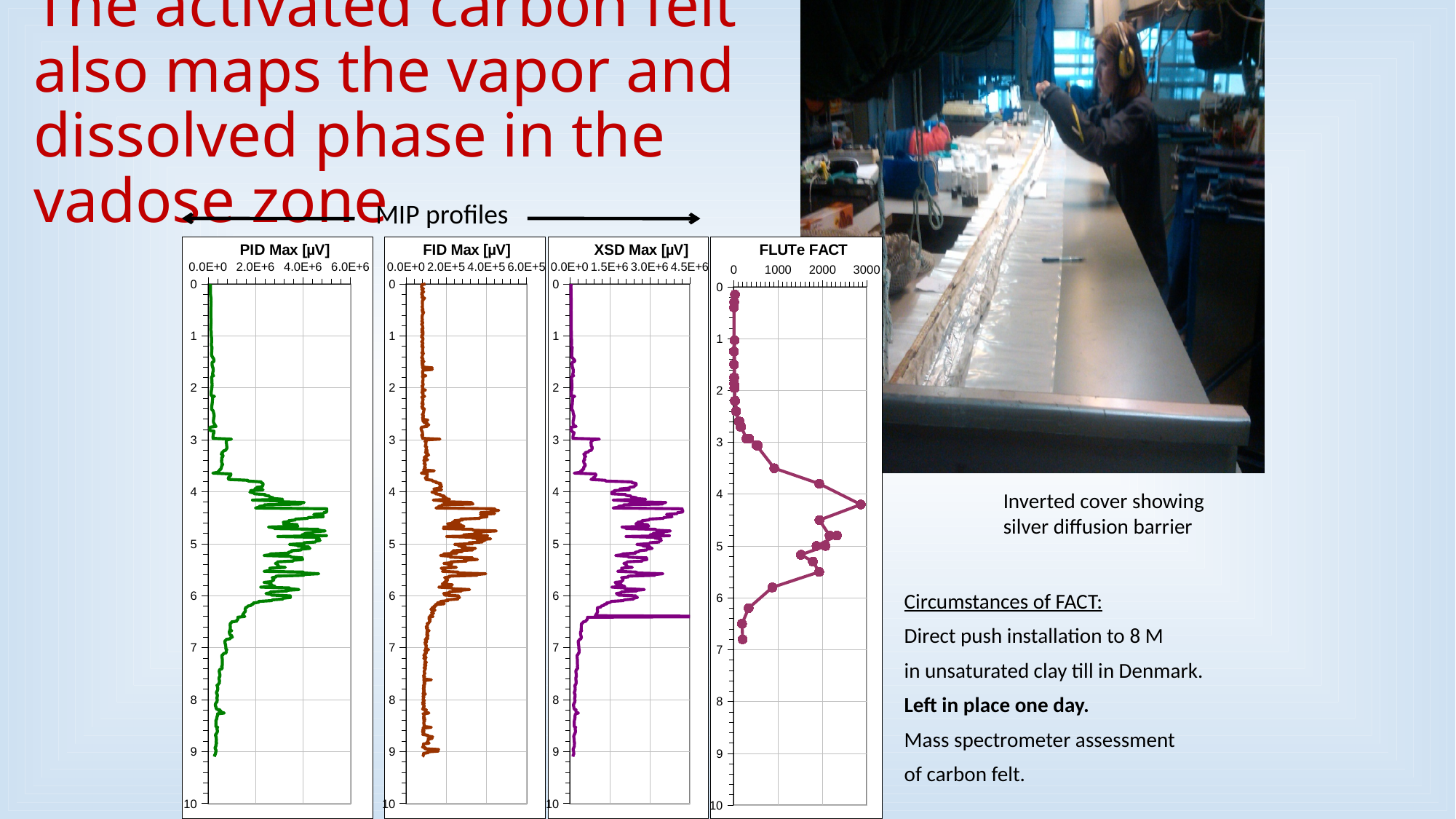
In the FLUTe FACT chart, is the peak value near a depth of 4 greater or less than 2000? greater In the FID Max [µV] chart, is the highest value reached between depths 4 and 5 greater or less than 4.0E+5? greater In the FLUTe FACT chart, do the values rise or fall as depth increases from 3 to 4? rise What is the maximum depth value shown on the vertical axis of the FID Max [µV] chart? 10 In the PID Max [µV] chart, is the highest value reached between depths 4 and 5 greater or less than 4.0E+6? greater How many profile charts are shown on the slide? 4 What is the title of the rightmost chart? FLUTe FACT What kind of chart is the PID Max [µV] chart? line chart What is the largest tick value on the x axis of the FLUTe FACT chart? 3000